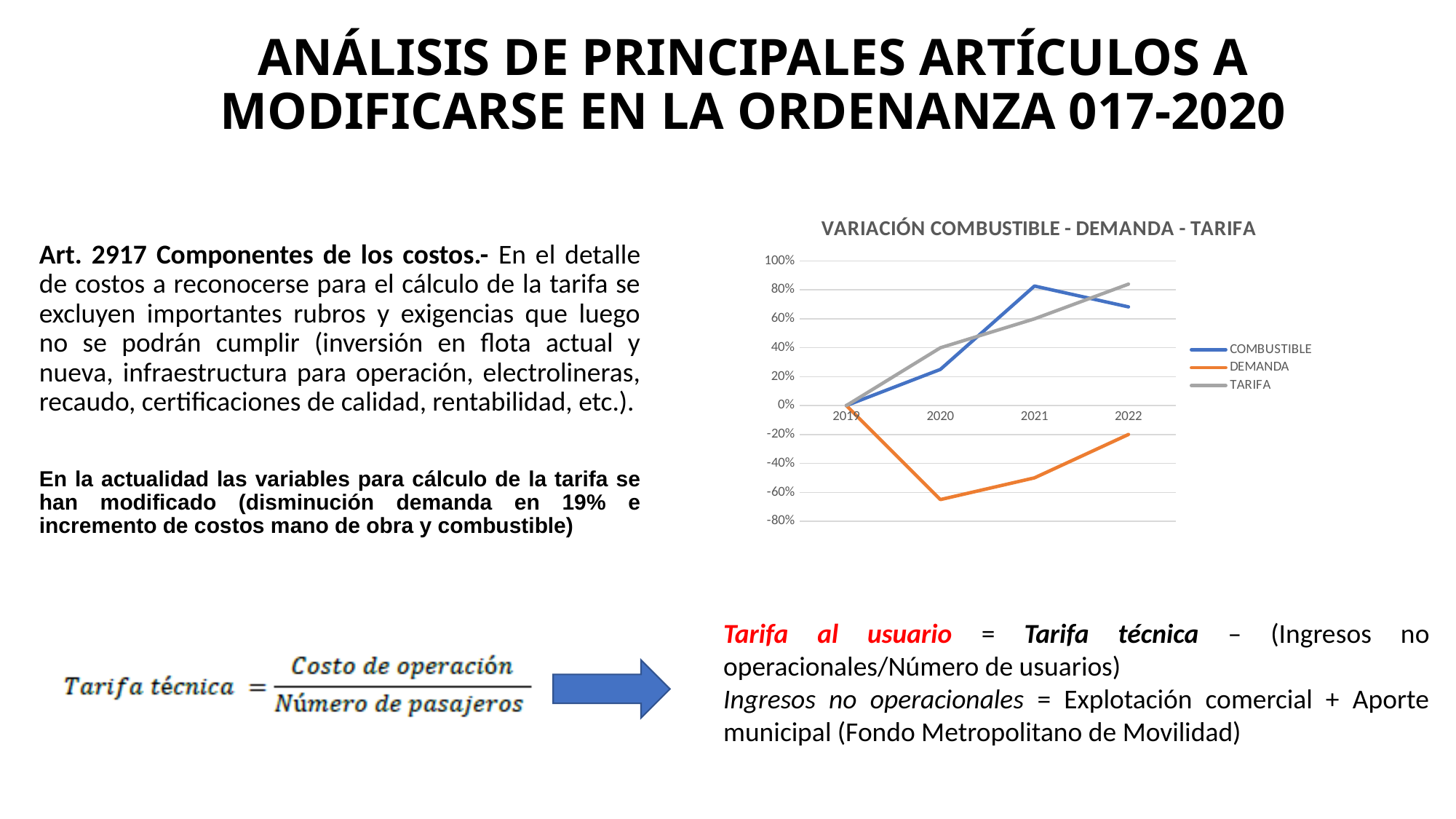
Does the TARIFA line rise or fall from 2019 to 2022? rise Is the value for DEMANDA in 2020 greater or less than -40%? less In 2021, which is larger: COMBUSTIBLE or TARIFA? COMBUSTIBLE Is the value for TARIFA in 2022 greater or less than 60%? greater In 2022, which is larger: TARIFA or COMBUSTIBLE? TARIFA In which year does COMBUSTIBLE reach its highest value? 2021 What is the value for COMBUSTIBLE in 2019? 0% How many series does the chart legend list? 3 What type of chart is shown on the slide? line chart What is the title of the chart? VARIACIÓN COMBUSTIBLE - DEMANDA - TARIFA Is the value for COMBUSTIBLE in 2021 greater or less than 60%? greater How many years are shown on the x axis of the chart? 4